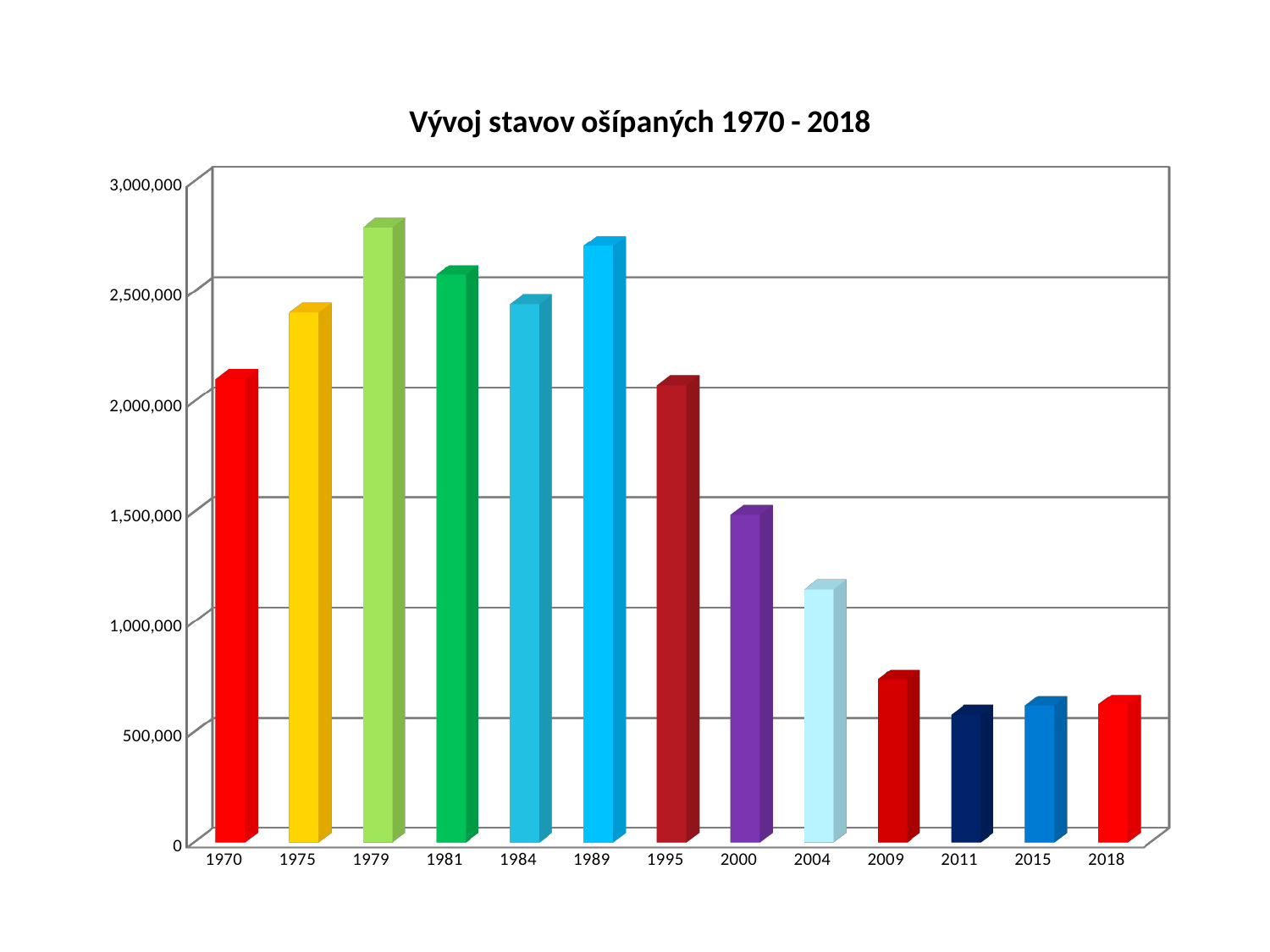
Which is larger, the value for 2009 or the value for 2011? 2009 How many years (categories) are shown on the x axis? 13 Which is larger, the value for 1970 or the value for 1975? 1975 Which year has the highest bar? 1979 Do the values rise or fall from 1989 to 2011? fall Is the value for 1975 greater or less than 2,500,000? less What is the title of the chart? Vývoj stavov ošípaných 1970 - 2018 Is the value for 2009 greater or less than 1,000,000? less Is the value for 1979 greater or less than 2,500,000? greater Which is larger, the value for 2000 or the value for 2004? 2000 What kind of chart is shown on the slide? bar chart